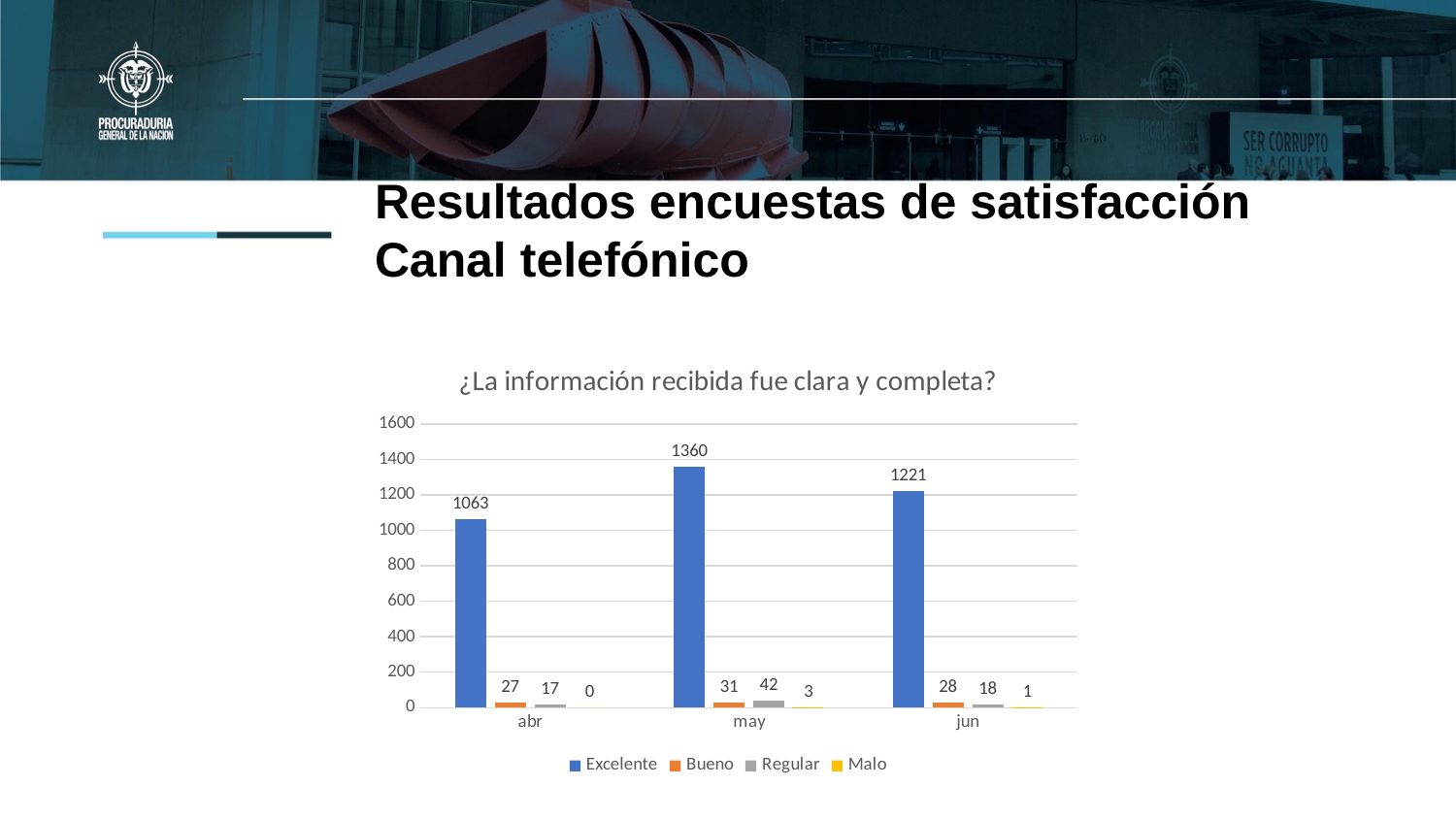
Which is larger, the Regular value in may or the Regular value in abr? may What is the difference between the Excelente values for may and jun? 139 What is the value for Regular in jun? 18 What is the value for Bueno in abr? 27 How many series does the legend list? 4 Which month has the lowest Excelente value? abr What is the value for Malo in may? 3 Is the Excelente value for jun greater or less than 1200? greater What kind of chart is shown on the slide? bar chart Which month has the highest Excelente value? may What is the value for Excelente in may? 1360 How many months are shown on the x axis? 3